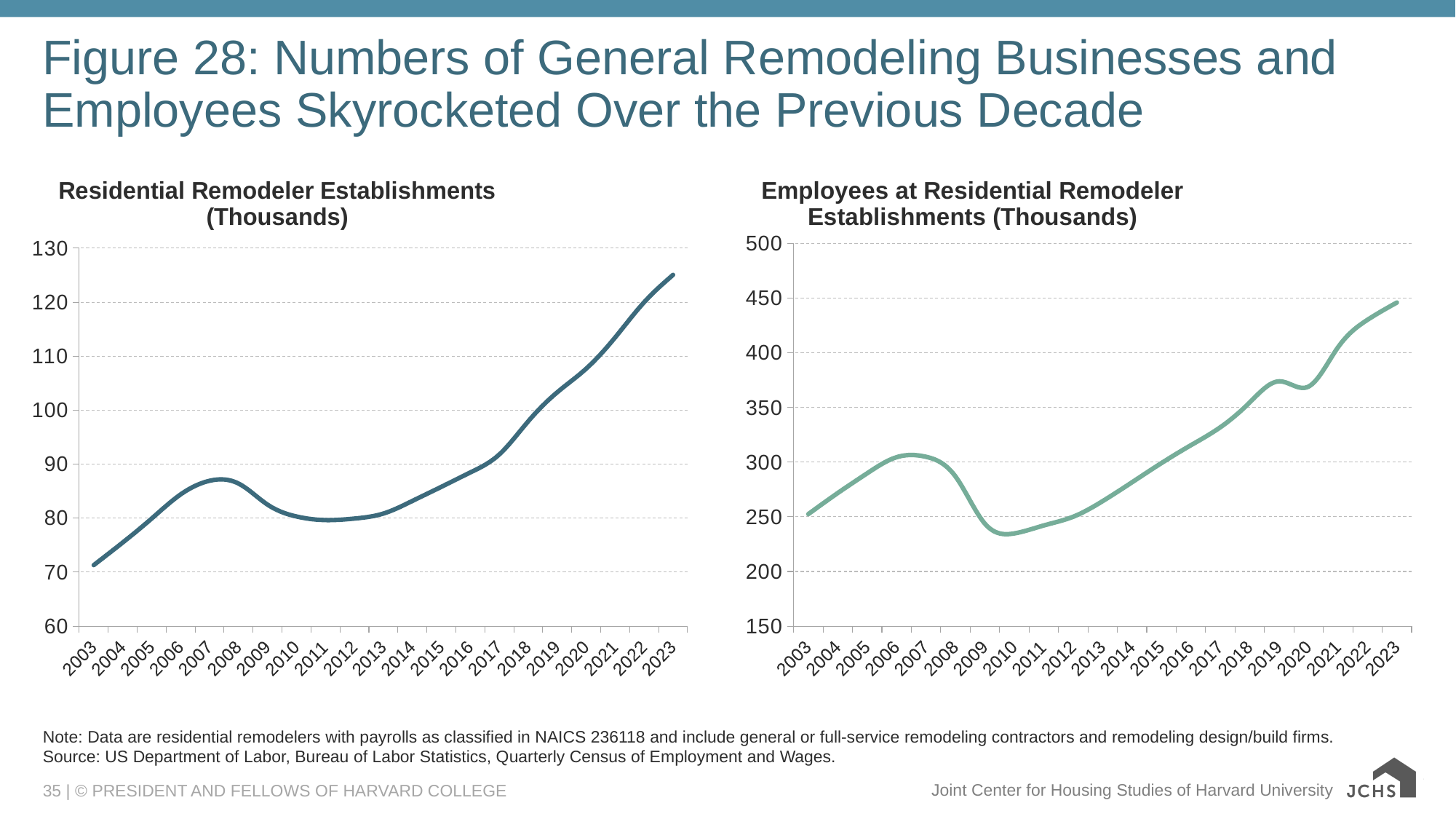
In the 'Residential Remodeler Establishments (Thousands)' chart, which year has the larger value, 2007 or 2011? 2007 In the 'Employees at Residential Remodeler Establishments (Thousands)' chart, which year has the highest value? 2023 In the 'Residential Remodeler Establishments (Thousands)' chart, is the value for 2023 greater or less than 120? greater In the 'Residential Remodeler Establishments (Thousands)' chart, is the value for 2013 greater or less than 90? less In the 'Employees at Residential Remodeler Establishments (Thousands)' chart, do values rise or fall between 2010 and 2023? rise What kind of chart is the 'Residential Remodeler Establishments (Thousands)' chart? line chart How many years are plotted on the x axis of the 'Employees at Residential Remodeler Establishments (Thousands)' chart? 21 In the 'Residential Remodeler Establishments (Thousands)' chart, which year has the highest value? 2023 In the 'Employees at Residential Remodeler Establishments (Thousands)' chart, is the value for 2010 greater or less than 250? less In the 'Employees at Residential Remodeler Establishments (Thousands)' chart, which year has the lowest value? 2010 In the 'Residential Remodeler Establishments (Thousands)' chart, which year has the lowest value? 2003